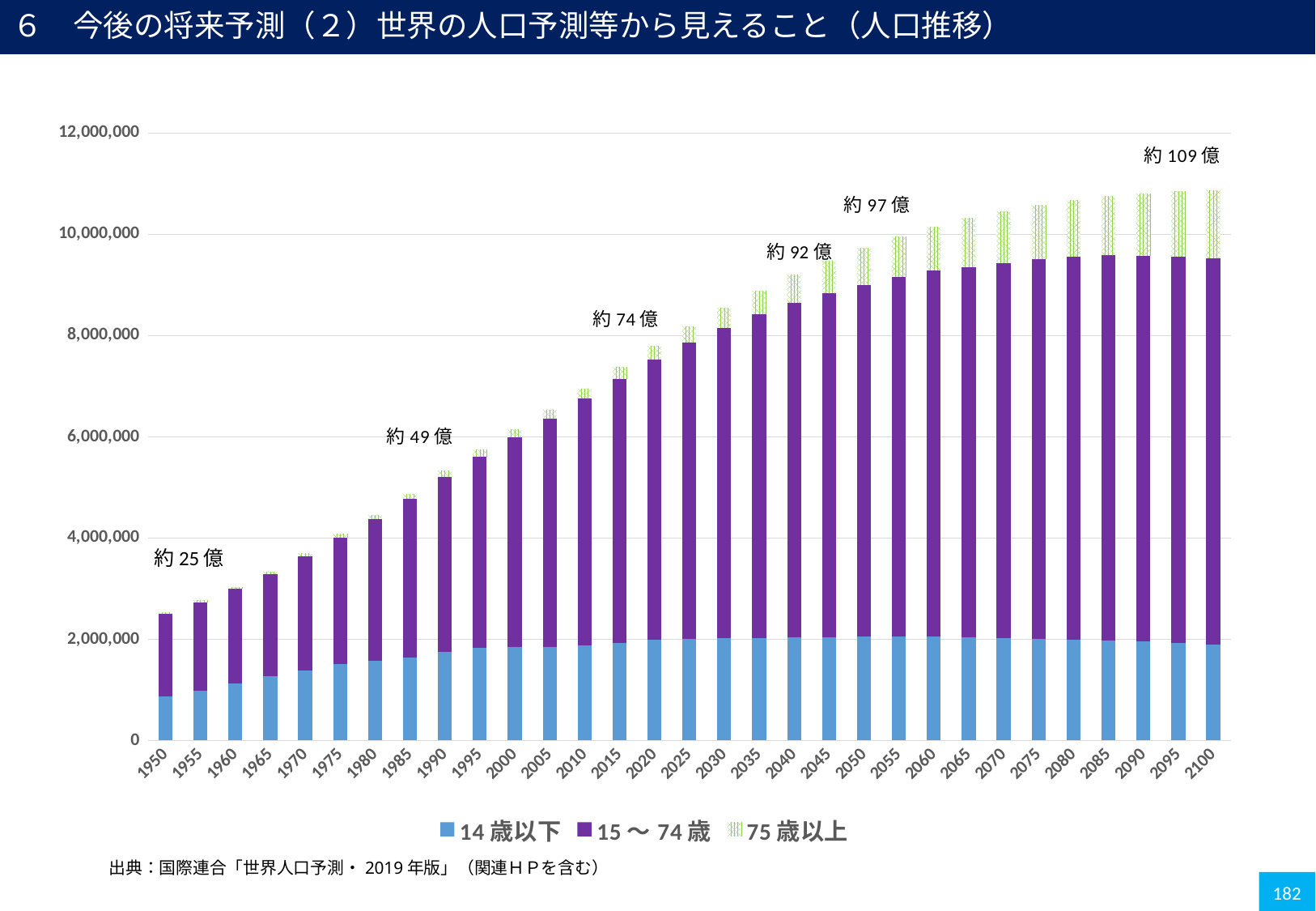
Which year has the larger total bar, 1950 or 2000? 2000 What is the highest value shown on the y axis? 12,000,000 Do the total bar heights generally rise or fall from 1950 to 2100? rise How many years (categories) are plotted along the x axis? 31 Which year has the lowest total population bar? 1950 What kind of chart is shown on the slide? bar chart Is the total bar for 1950 greater or less than 4,000,000? less How many series does the legend list? 3 What annotation is printed above the 2100 bar? 約109億 Is the total bar for 2100 greater or less than 10,000,000? greater Is the total bar for 2020 greater or less than 6,000,000? greater